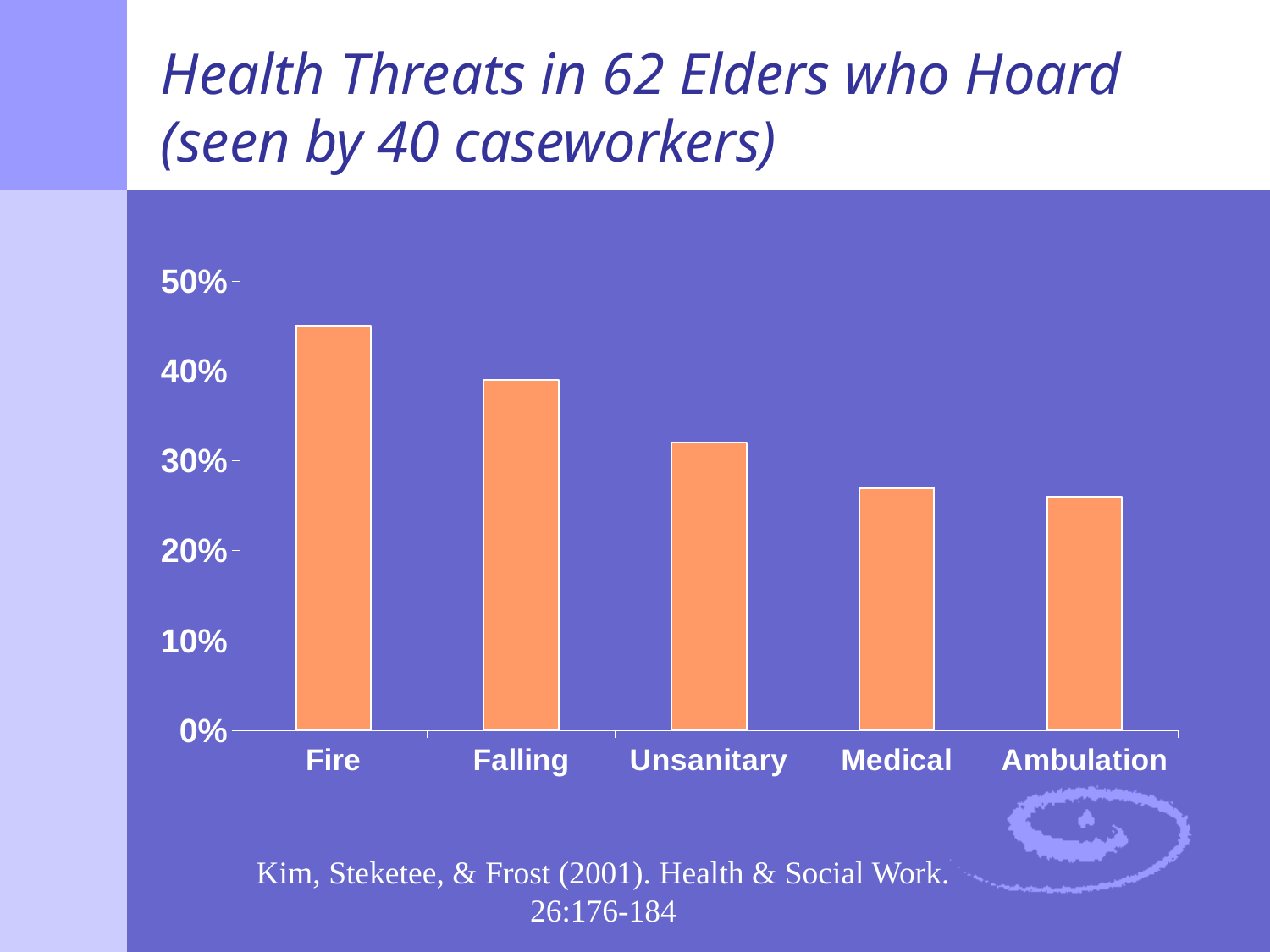
Is the value for Medical greater or less than 30%? less Is the value for Unsanitary greater or less than 30%? greater Which health threat has the highest bar? Fire Do the bar values rise or fall from left to right across the categories? fall Is the value for Fire greater or less than 40%? greater What is the title of the chart on the slide? Health Threats in 62 Elders who Hoard (seen by 40 caseworkers) How many categories are plotted in the chart? 5 Which is larger, the value for Fire or the value for Unsanitary? Fire What kind of chart is shown on the slide? bar chart Which is larger, the value for Falling or the value for Medical? Falling